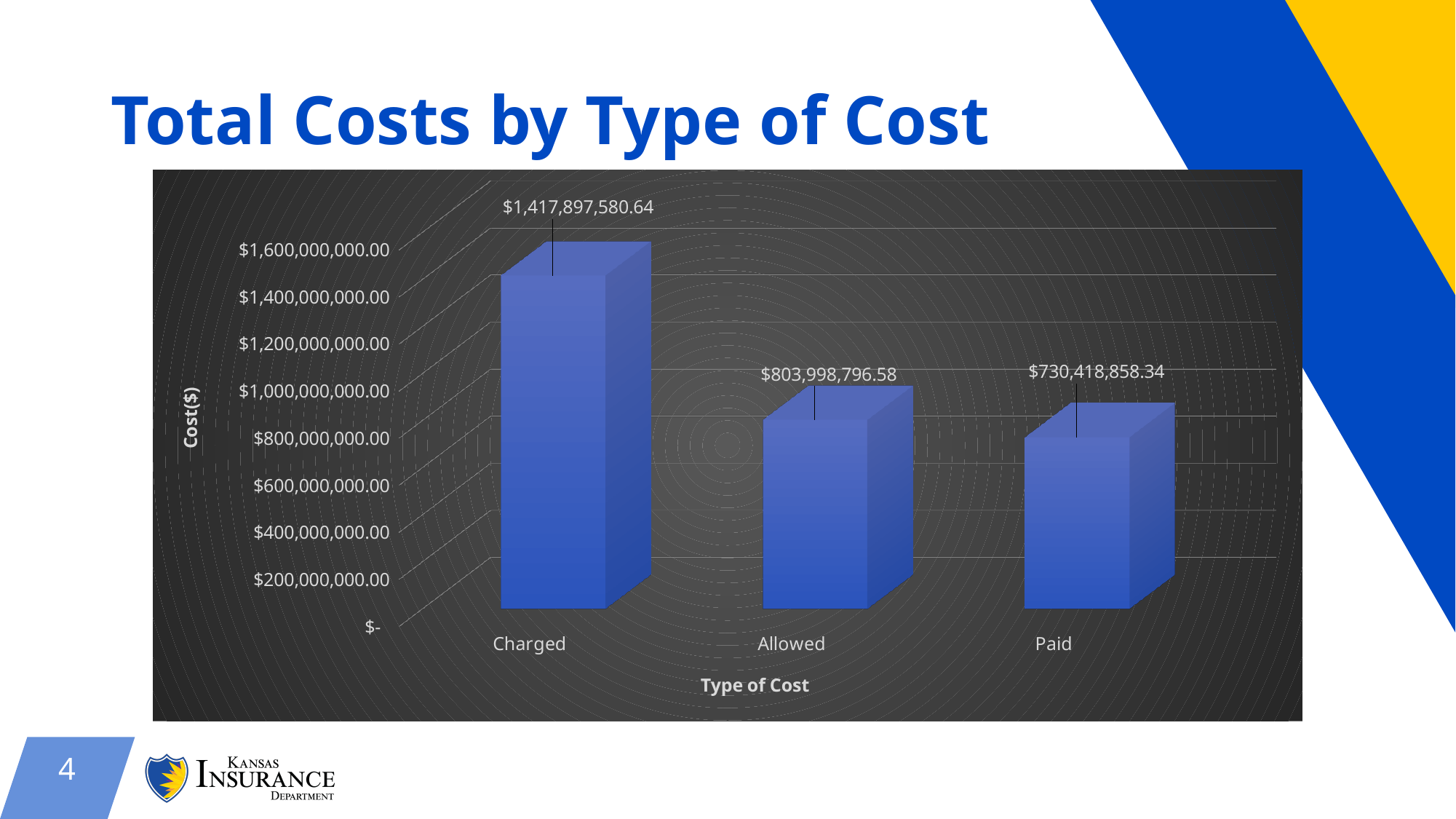
What is the difference between the Allowed and Paid values? $73,579,938.24 What is the value for Charged? $1,417,897,580.64 Which is larger, the value for Allowed or the value for Paid? Allowed What is the difference between the Charged and Allowed values? $613,898,784.06 How many types of cost are shown on the chart? 3 Is the value for Charged greater or less than $1,000,000,000.00? greater What is the value for Paid? $730,418,858.34 Which type of cost has the lowest value? Paid What is the title of the vertical axis? Cost($) What is the value for Allowed? $803,998,796.58 Which type of cost has the highest value? Charged What kind of chart is shown on the slide? Bar chart